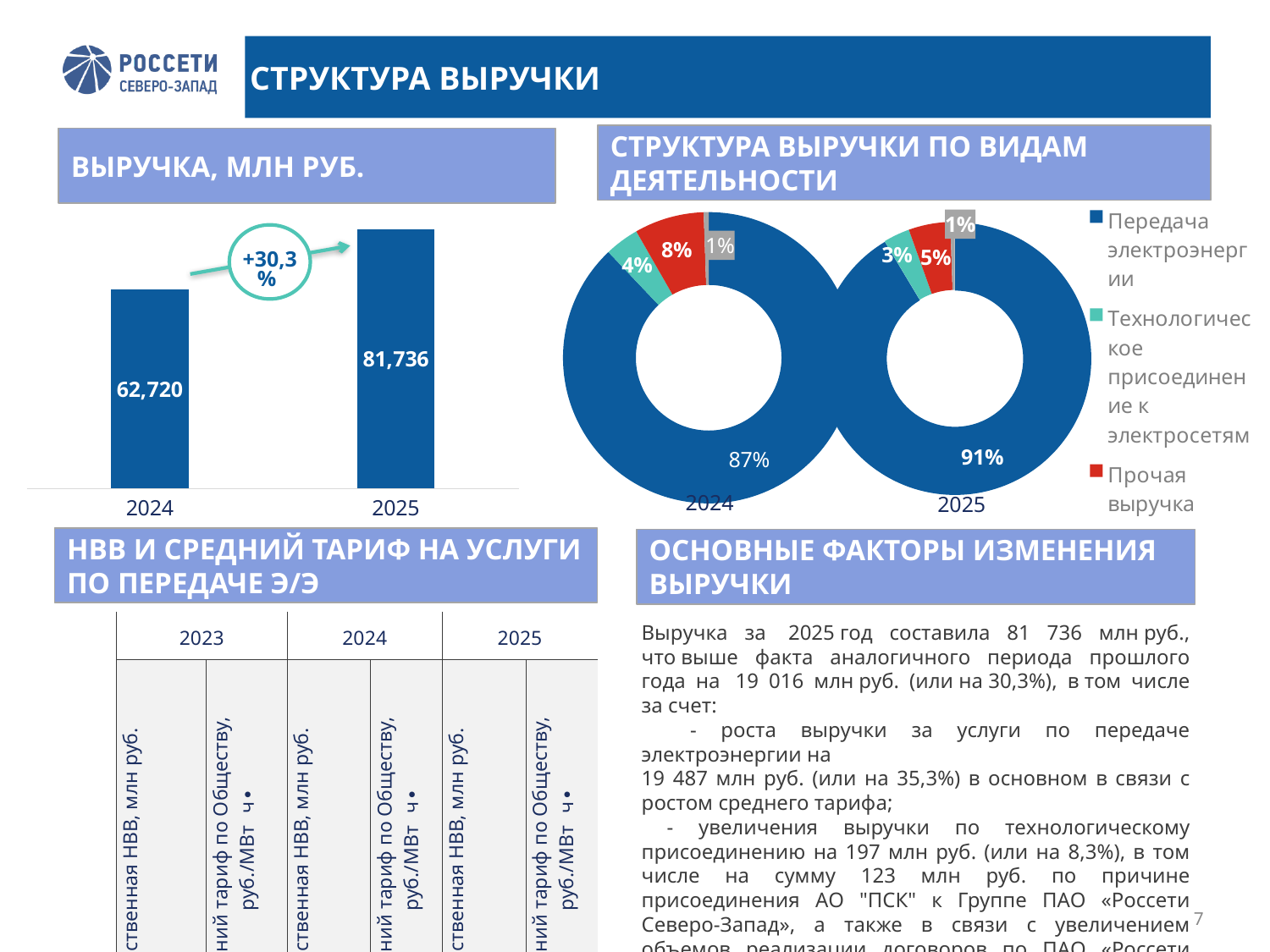
In the chart titled "ВЫРУЧКА, МЛН РУБ.", which year has the higher value? 2025 In the chart titled "ВЫРУЧКА, МЛН РУБ.", what is the difference between the 2025 and 2024 values? 19,016 In the chart titled "СТРУКТУРА ВЫРУЧКИ ПО ВИДАМ ДЕЯТЕЛЬНОСТИ", what share does "Передача электроэнергии" have in 2024? 87% In the chart titled "ВЫРУЧКА, МЛН РУБ.", how many years are plotted? 2 In the chart titled "ВЫРУЧКА, МЛН РУБ.", what is the value for 2024? 62,720 In the chart titled "ВЫРУЧКА, МЛН РУБ.", what is the value for 2025? 81,736 In the chart titled "СТРУКТУРА ВЫРУЧКИ ПО ВИДАМ ДЕЯТЕЛЬНОСТИ", what share does "Передача электроэнергии" have in 2025? 91% In the chart titled "ВЫРУЧКА, МЛН РУБ.", what percentage change is shown between 2024 and 2025? +30,3 % What type of chart is the chart titled "ВЫРУЧКА, МЛН РУБ."? bar chart In the chart titled "СТРУКТУРА ВЫРУЧКИ ПО ВИДАМ ДЕЯТЕЛЬНОСТИ", is the share of "Прочая выручка" larger in 2024 or in 2025? 2024 In the chart titled "СТРУКТУРА ВЫРУЧКИ ПО ВИДАМ ДЕЯТЕЛЬНОСТИ", what share does "Прочая выручка" have in 2024? 8%